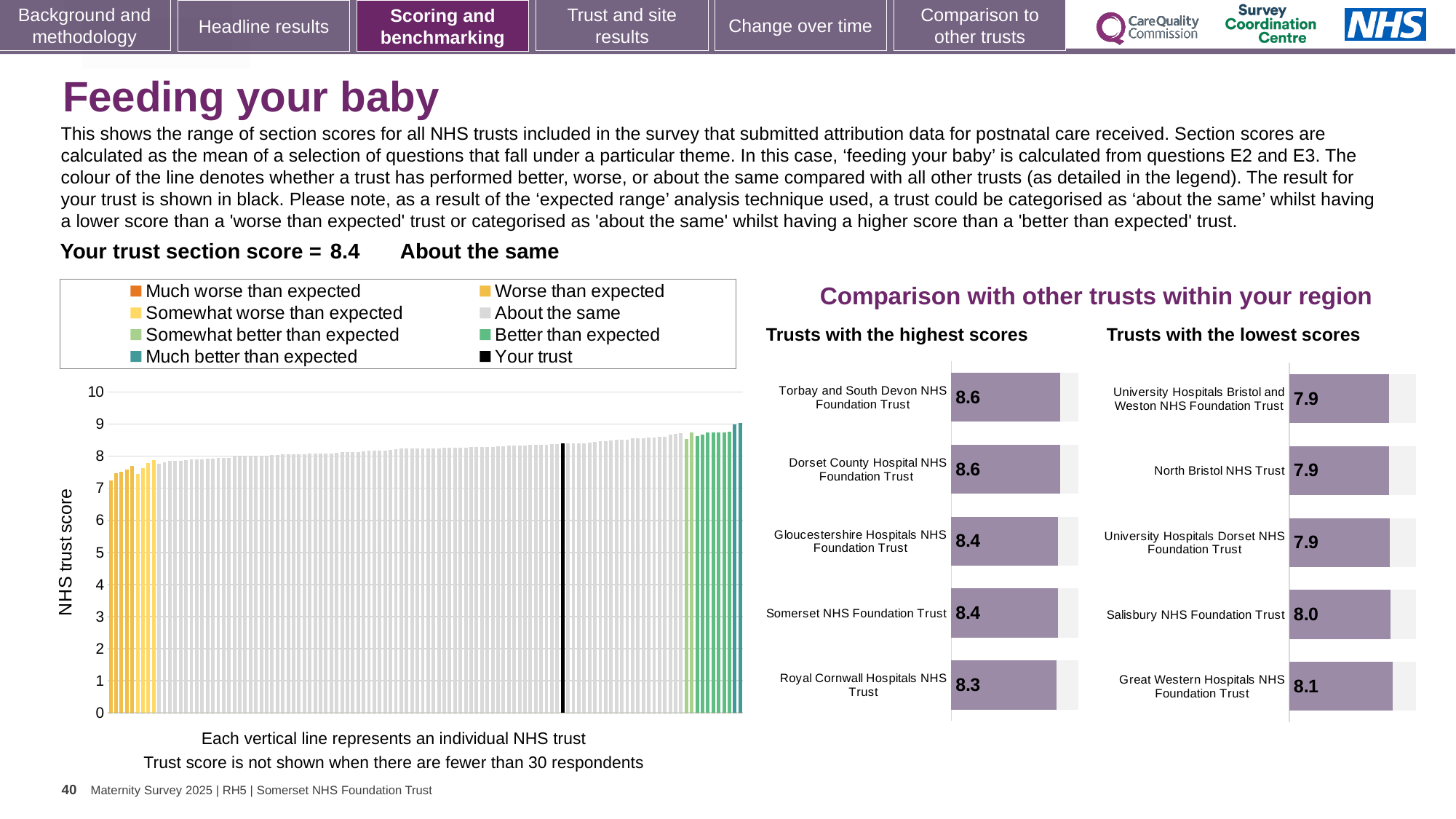
In the 'Trusts with the lowest scores' chart, which trust has the highest score? Great Western Hospitals NHS Foundation Trust How many entries does the legend above the large chart on the left list? 8 In the 'Trusts with the highest scores' chart, what is the score for Torbay and South Devon NHS Foundation Trust? 8.6 In the large chart on the left, do the trust scores rise or fall from left to right? Rise How many trusts are shown in the 'Trusts with the lowest scores' chart? 5 In the 'Trusts with the lowest scores' chart, what is the score for Salisbury NHS Foundation Trust? 8.0 In the large chart on the left, is the value of the leftmost bar greater or less than 8? less What kind of chart is the large chart on the left showing NHS trust scores? Bar chart In the 'Trusts with the lowest scores' chart, which has the larger score: Great Western Hospitals NHS Foundation Trust or Salisbury NHS Foundation Trust? Great Western Hospitals NHS Foundation Trust In the 'Trusts with the highest scores' chart, what is the score for Royal Cornwall Hospitals NHS Trust? 8.3 In the 'Trusts with the highest scores' chart, what is the difference between the scores of Torbay and South Devon NHS Foundation Trust and Royal Cornwall Hospitals NHS Trust? 0.3 In the 'Trusts with the highest scores' chart, which trust has the lowest score? Royal Cornwall Hospitals NHS Trust